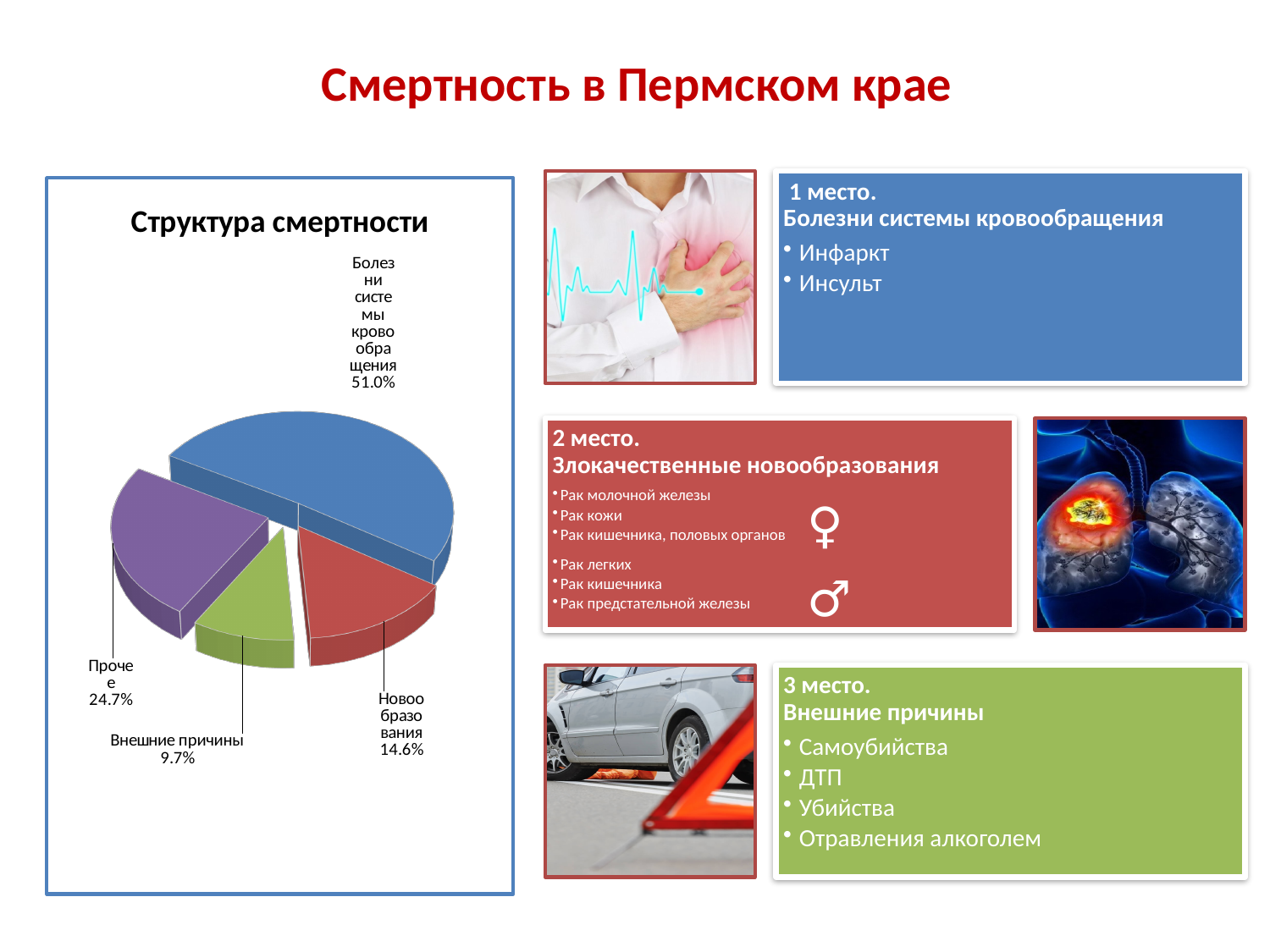
How many slices does the pie chart have? 4 Which category has the largest slice of the pie? Болезни системы кровообращения What is the value shown for Внешние причины? 9.7% What colour is the slice for Болезни системы кровообращения? blue What share of the pie is Болезни системы кровообращения? 51.0% Which category has the smallest slice of the pie? Внешние причины Which is larger, the share for Новообразования or the share for Внешние причины? Новообразования What is the value shown for Прочее? 24.7% What is the difference between the shares of Прочее and Новообразования? 10.1% What is the value shown for Новообразования? 14.6% What is the title of the chart? Структура смертности What kind of chart is shown on the slide? pie chart